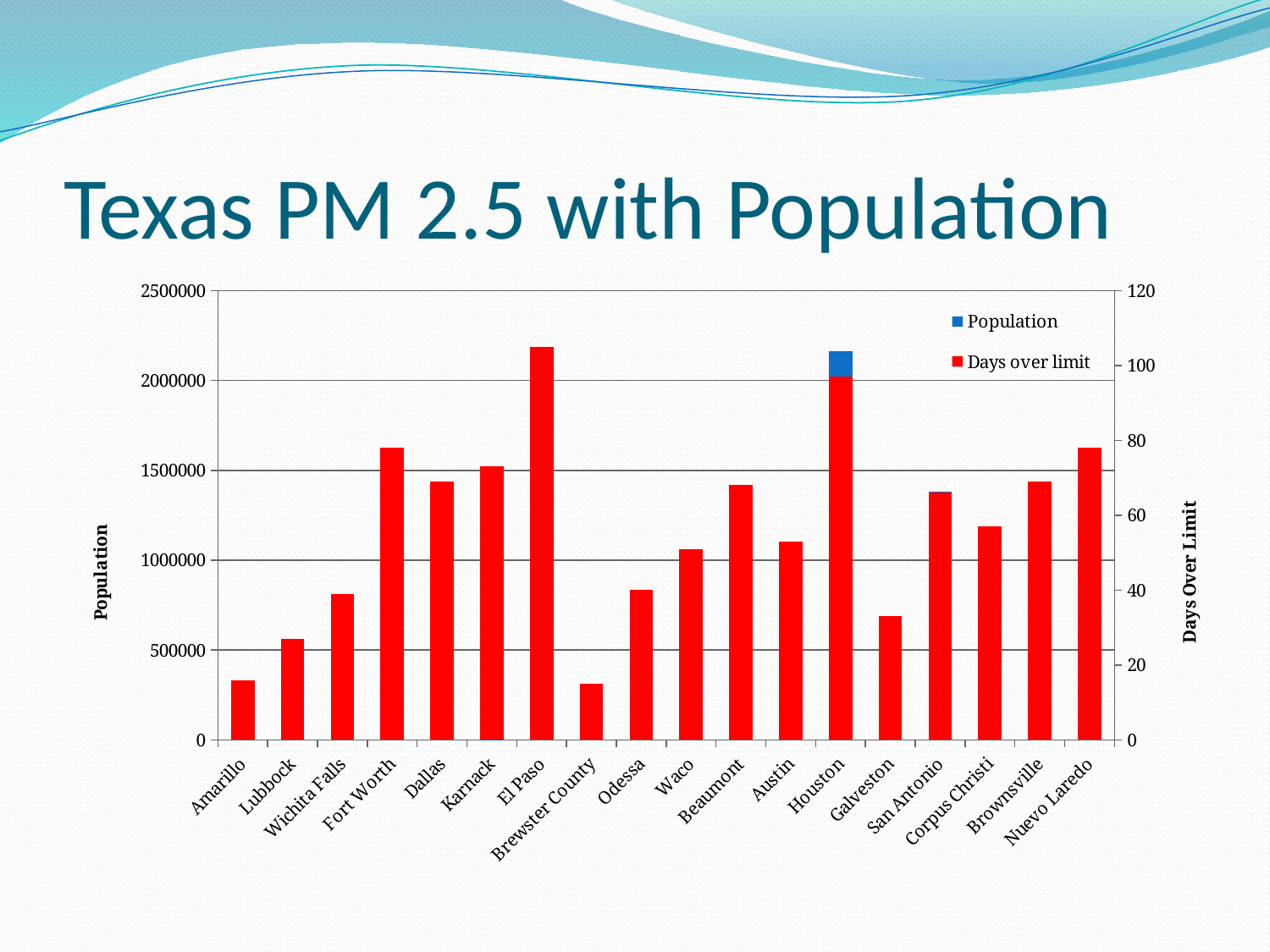
Is the number of days over limit for Lubbock greater or less than 20? greater Is the number of days over limit for Dallas greater or less than 80? less What is the title of the slide? Texas PM 2.5 with Population Which location has the highest number of days over limit? El Paso What kind of chart is shown on the slide? bar chart How many cities or counties are shown along the x axis? 18 Which has more days over limit, Amarillo or Lubbock? Lubbock How many series does the legend list? 2 Is the population value shown for Houston greater or less than 2000000? greater Which has more days over limit, Fort Worth or Dallas? Fort Worth